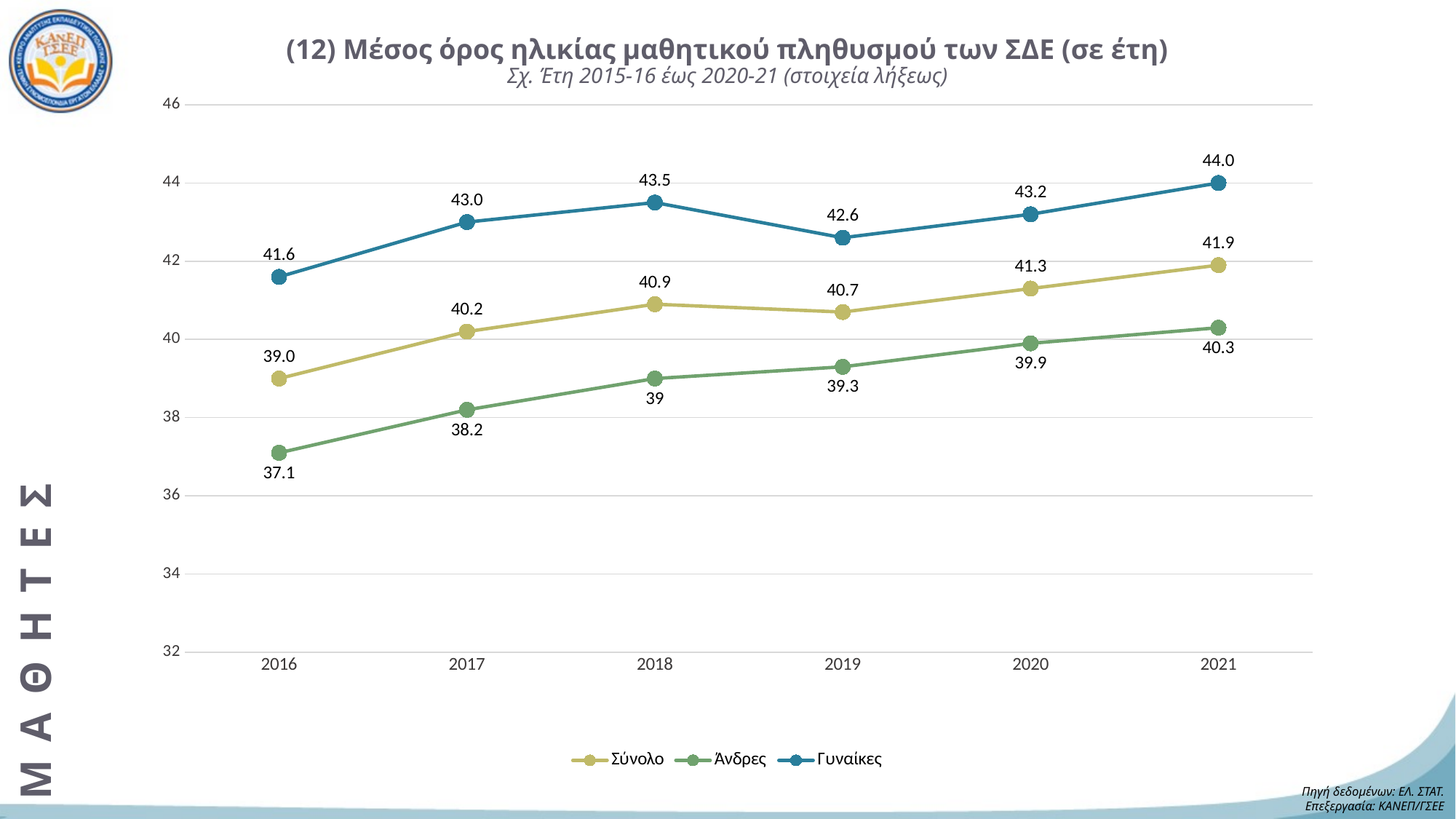
Which series is drawn in blue? Γυναίκες In which year is the value for Σύνολο highest? 2021 What is the value for Άνδρες in 2016? 37.1 Which is larger, the Γυναίκες value in 2018 or the Γυναίκες value in 2019? 2018 What is the value for Σύνολο in 2019? 40.7 Does the Άνδρες series rise or fall from 2016 to 2021? rise In which year is the value for Γυναίκες lowest? 2016 How many years are shown on the x axis? 6 What is the difference between the Γυναίκες and Άνδρες values in 2021? 3.7 How many series does the legend list? 3 What is the value for Γυναίκες in 2021? 44.0 What kind of chart is this? line chart